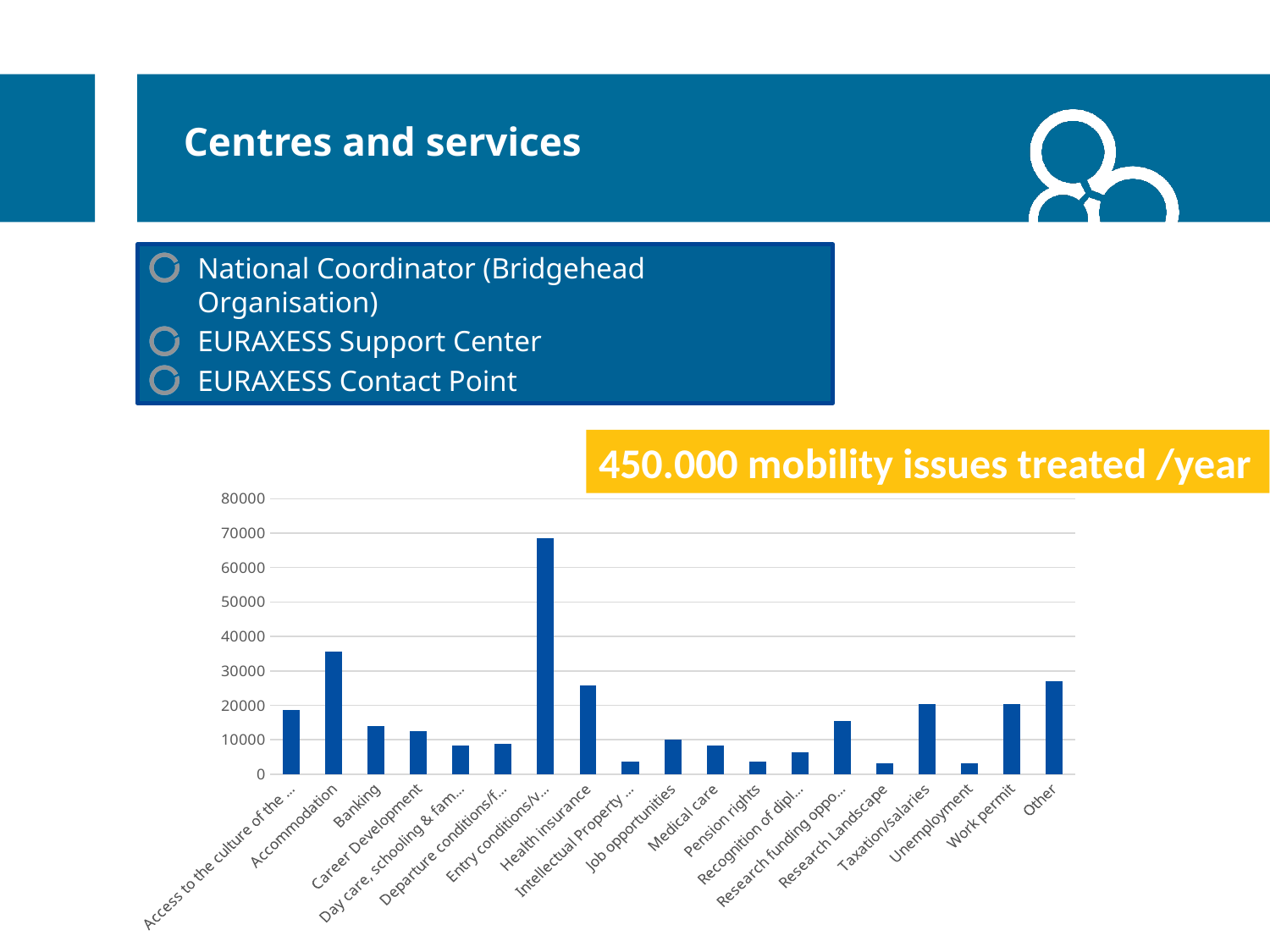
Which is larger, the value for Other or the value for Banking? Other Which is larger, the value for Accommodation or the value for Health insurance? Accommodation How many categories are shown on the x axis of the chart? 19 Which category has the highest bar in the chart? Entry conditions/v... Is the value for Banking greater or less than 10000? greater What kind of chart is shown on the slide? bar chart Is the value for Accommodation greater or less than 30000? greater Is the value for Health insurance greater or less than 20000? greater What is the highest value shown on the chart's vertical axis? 80000